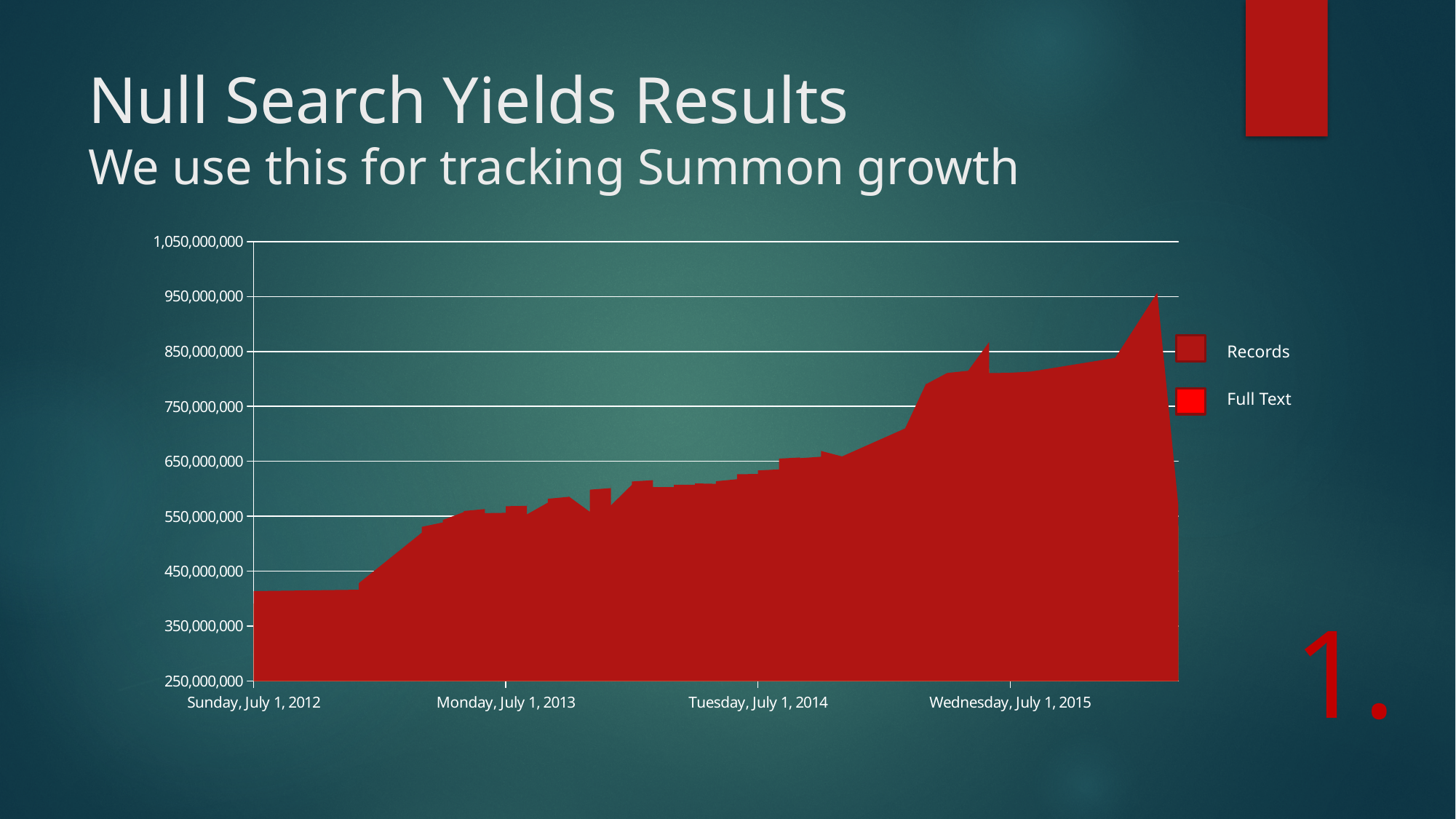
Is the value at Monday, July 1, 2013 greater or less than 450,000,000? greater Is the value at Sunday, July 1, 2012 greater or less than 450,000,000? less Is the value at Wednesday, July 1, 2015 greater or less than 750,000,000? greater How many series does the chart legend list? 2 What kind of chart is shown on the slide? area chart What are the two series named in the chart legend? Records and Full Text Which is larger, the value at Sunday, July 1, 2012 or the value at Wednesday, July 1, 2015? Wednesday, July 1, 2015 What is the highest value labelled on the chart's y axis? 1,050,000,000 How many date labels are shown on the x axis of the chart? 4 Do the values in the chart generally rise or fall from July 2012 to 2015? rise